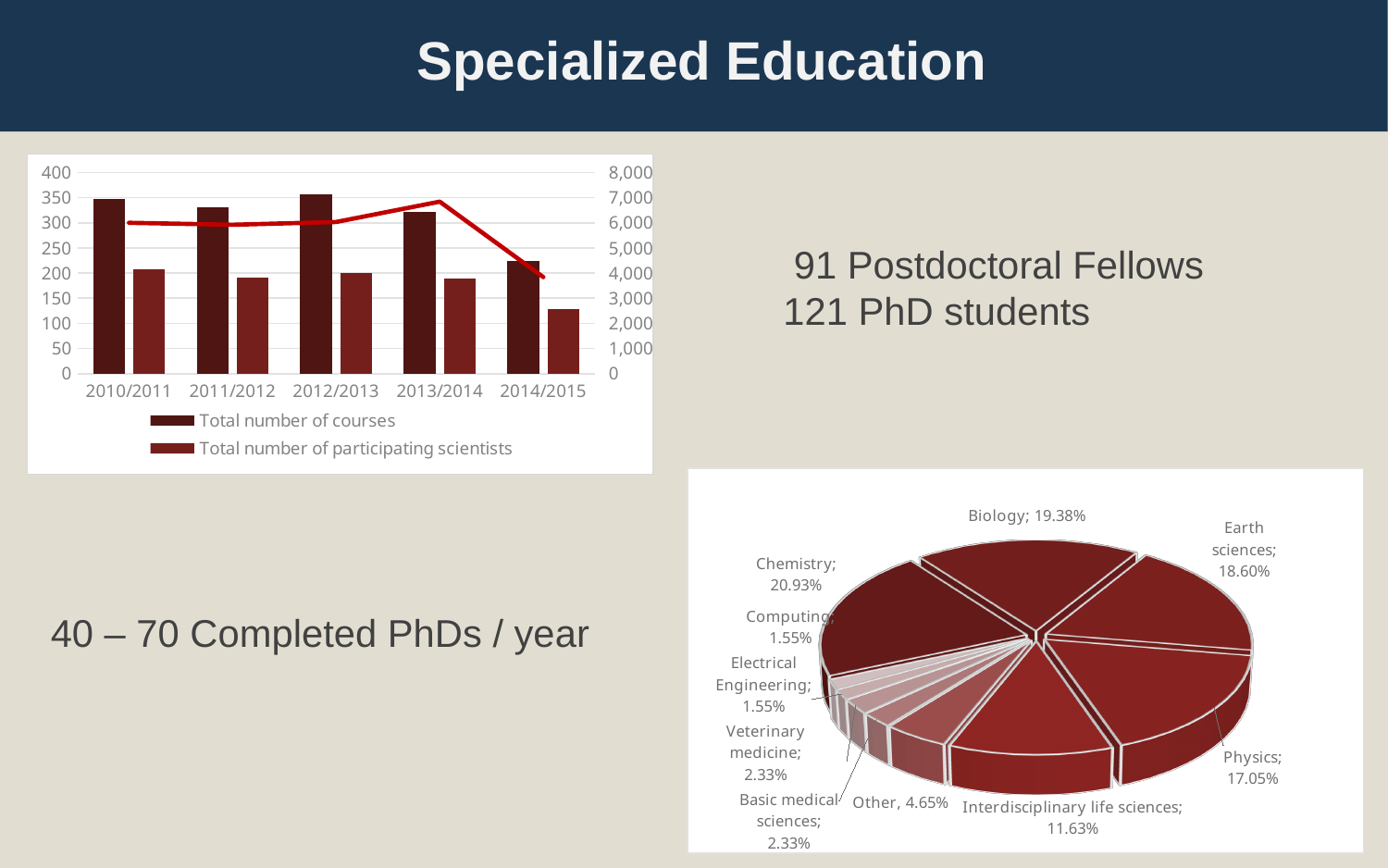
In the top-left bar chart, is the total number of participating scientists for 2014/2015 greater or less than 150? less In the bottom-right pie chart, what share does Biology have? 19.38% What kind of chart is the chart at the top left of the slide? combination bar and line chart In the bottom-right pie chart, what is the difference between the Chemistry share and the Biology share? 1.55% In the bottom-right pie chart, which category has the largest share? Chemistry In the top-left bar chart, is the total number of courses for 2014/2015 greater or less than 250? less In the top-left bar chart, how many series does the legend list? 2 In the top-left bar chart, which year has the lowest total number of courses? 2014/2015 In the top-left bar chart, is the total number of courses for 2012/2013 greater or less than 300? greater In the top-left bar chart, how many academic years are shown on the x axis? 5 In the bottom-right pie chart, which has the larger share, Earth sciences or Physics? Earth sciences What kind of chart is the chart at the bottom right of the slide? pie chart